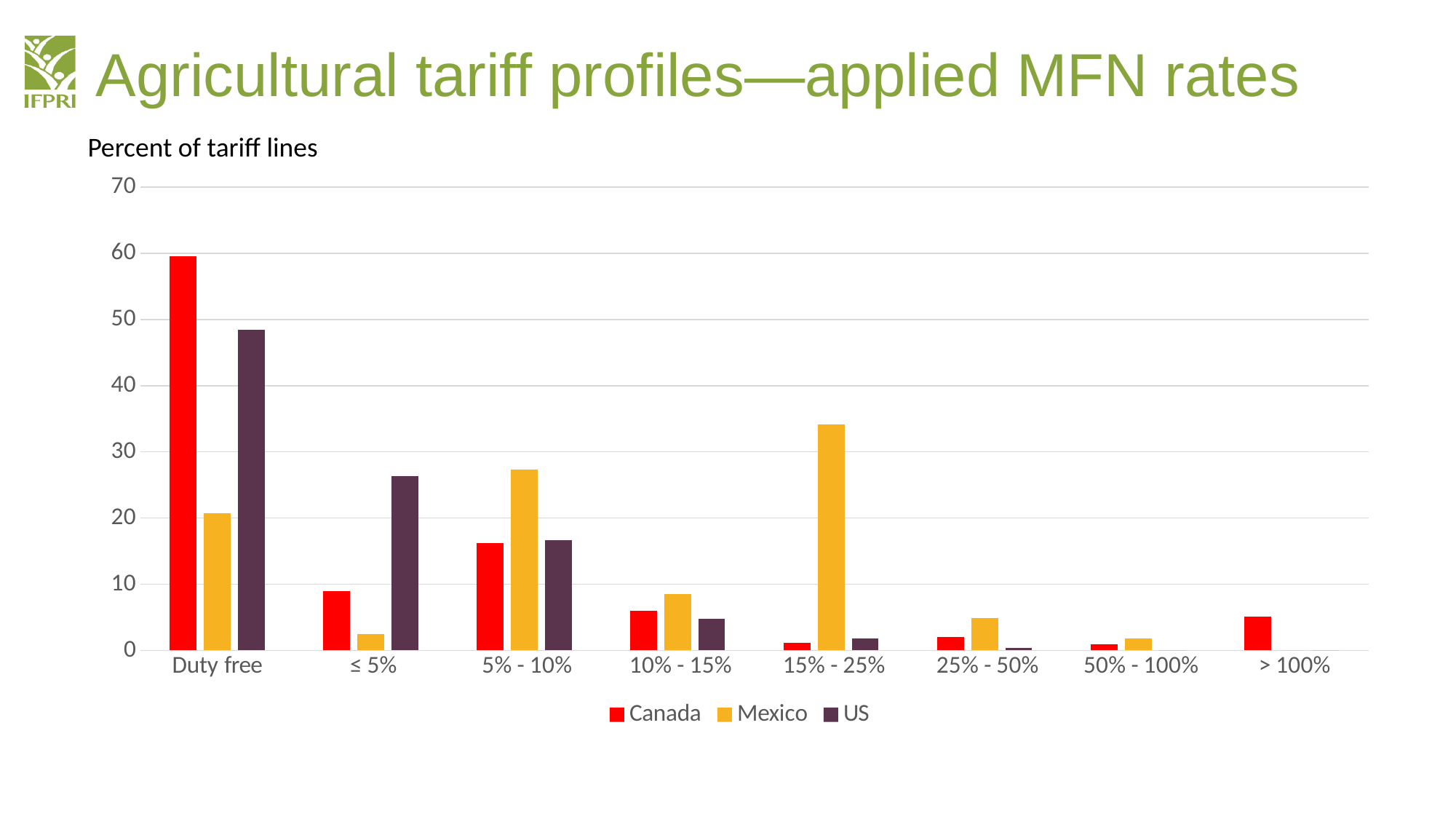
Is the value for Canada in the Duty free category greater or less than 50? greater Is the value for US in the ≤ 5% category greater or less than 30? less What does the y axis of the chart measure, according to the label above it? Percent of tariff lines What kind of chart is shown on the slide? bar chart In the 15% - 25% category, which is larger, the value for Mexico or the value for Canada? Mexico Which country has the highest value in the Duty free category? Canada Is the value for Mexico in the 15% - 25% category greater or less than 30? greater How many series does the legend list? 3 In which category does Mexico have its highest value? 15% - 25% In the ≤ 5% category, which is larger, the value for US or the value for Canada? US How many tariff-rate categories are shown on the x axis? 8